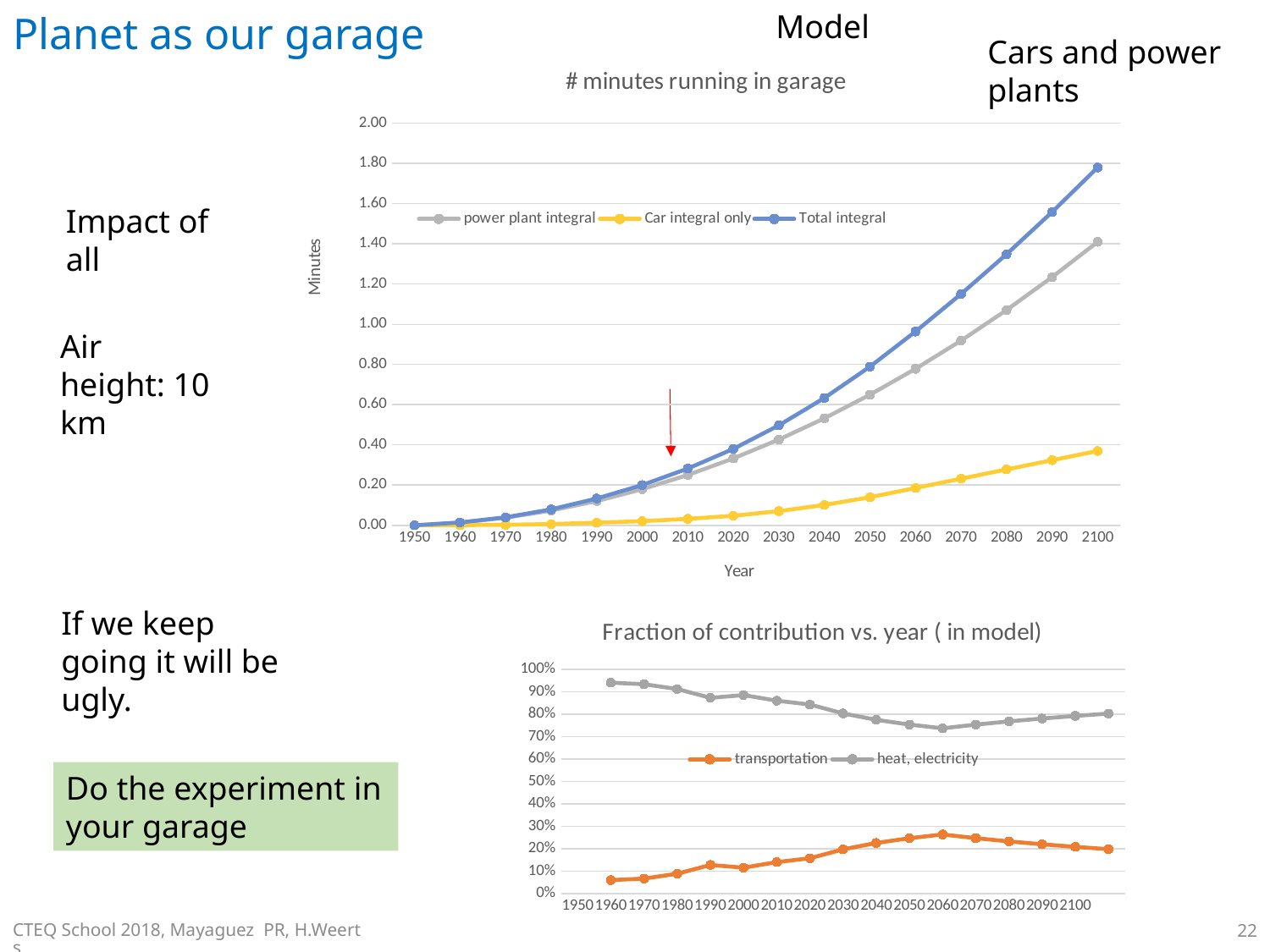
In the bottom chart 'Fraction of contribution vs. year ( in model)', is the heat, electricity value for 1960 greater or less than 90%? greater In the top chart '# minutes running in garage', is the Total integral value for 2100 greater or less than 1.60? greater In the top chart '# minutes running in garage', is the Car integral only value for 2100 greater or less than 0.60? less How many series does the legend of the bottom chart 'Fraction of contribution vs. year ( in model)' list? 2 In the top chart '# minutes running in garage', does the Total integral rise or fall from 1950 to 2100? rise In the bottom chart 'Fraction of contribution vs. year ( in model)', in which year does the transportation series reach its highest value? 2060 In the top chart '# minutes running in garage', which series is larger in 2100, Total integral or Car integral only? Total integral What type of chart is the top chart titled '# minutes running in garage'? line chart In the bottom chart 'Fraction of contribution vs. year ( in model)', which series is larger in 2000, transportation or heat, electricity? heat, electricity In the top chart '# minutes running in garage', how many years are marked along the x axis? 16 How many series does the legend of the top chart '# minutes running in garage' list? 3